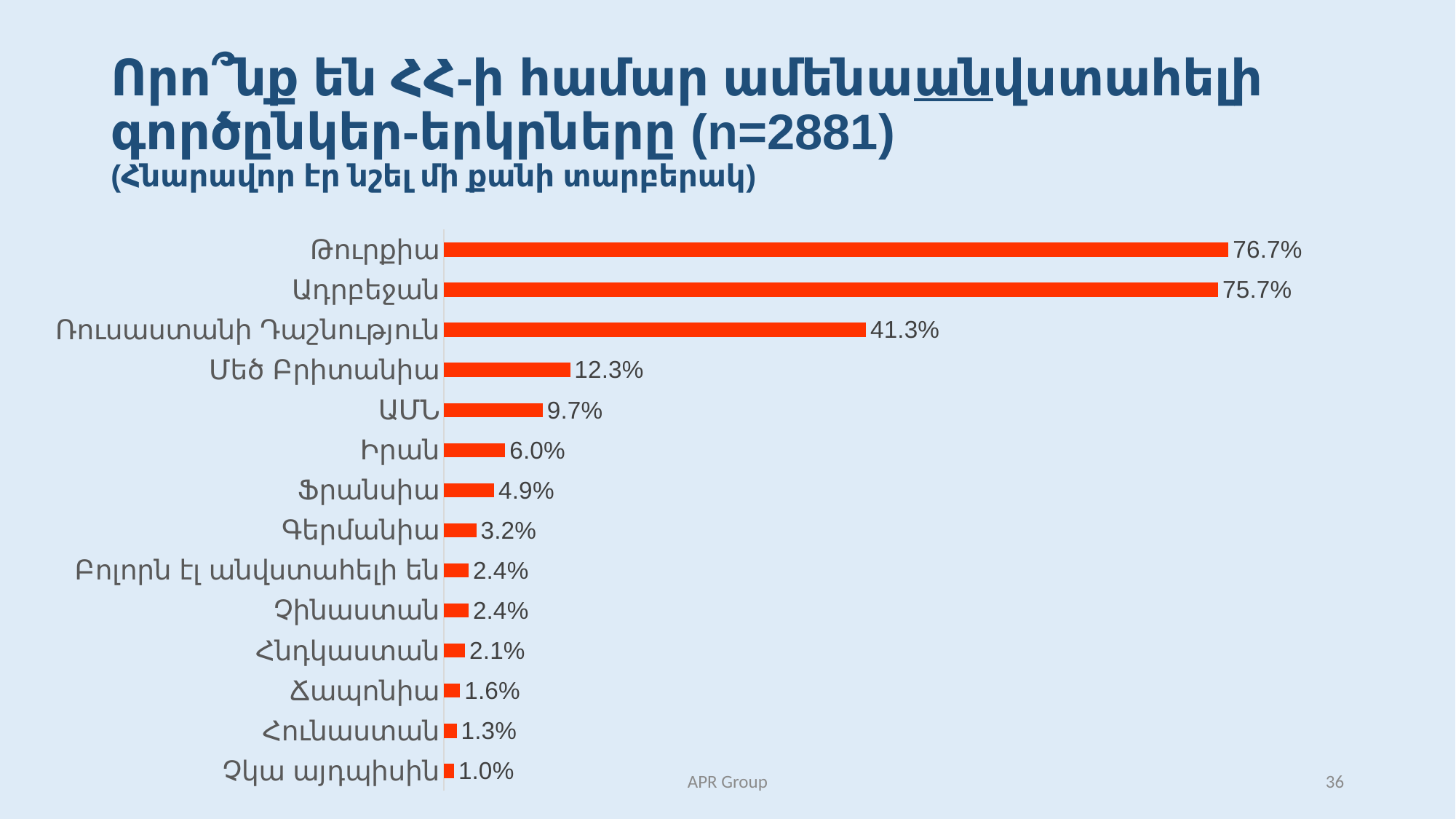
Which category has the highest value? Թուրքիա What colour are the bars in the chart? Red-orange What value is shown for Ռուսաստանի Դաշնություն? 41.3% Which category has the lowest value? Չկա այդպիսին How many categories are shown in the chart? 14 What kind of chart is shown on the slide? Bar chart What value is shown for Գերմանիա? 3.2% What value is shown for ԱՄՆ? 9.7% What value is shown for Թուրքիա? 76.7% What is the difference between the values for Մեծ Բրիտանիա and ԱՄՆ? 2.6% What is the difference between the values for Թուրքիա and Ադրբեջան? 1.0% Which has a larger value, Իրան or Ֆրանսիա? Իրան